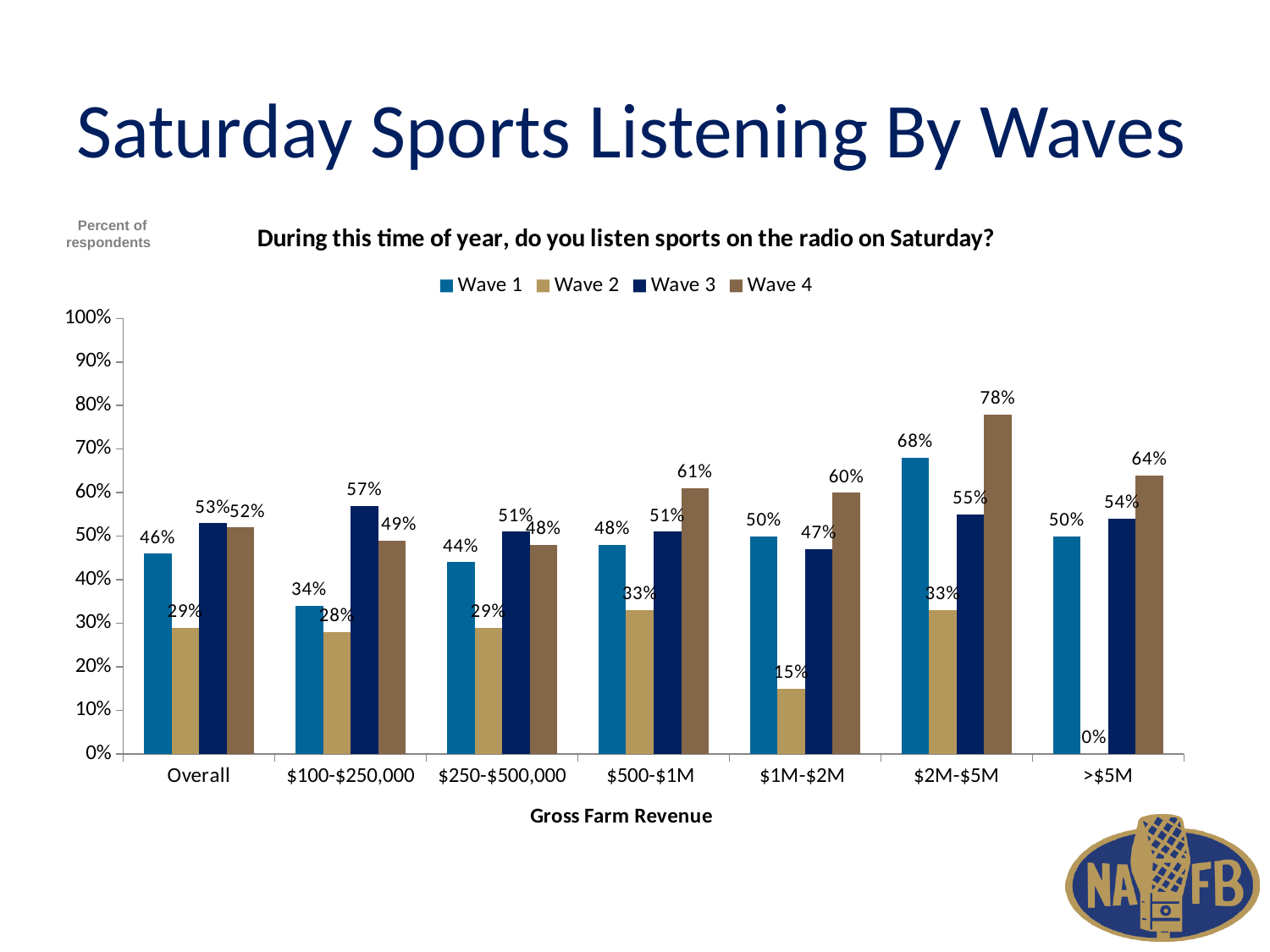
How many series does the legend list? 4 Which Gross Farm Revenue category has the lowest Wave 2 value? >$5M What is the Wave 2 value for the $1M-$2M category? 15% What kind of chart is shown on the slide? Bar chart What is the difference between the Wave 4 and Wave 1 values for the $2M-$5M category? 10% How many Gross Farm Revenue categories are shown on the x axis? 7 What is the Wave 1 value for the Overall category? 46% What is the Wave 3 value for the $100-$250,000 category? 57% What is the Wave 4 value for the $2M-$5M category? 78% What is the x-axis title of the chart? Gross Farm Revenue For the $1M-$2M category, which is larger: the Wave 1 value or the Wave 3 value? Wave 1 Which Gross Farm Revenue category has the highest Wave 1 value? $2M-$5M